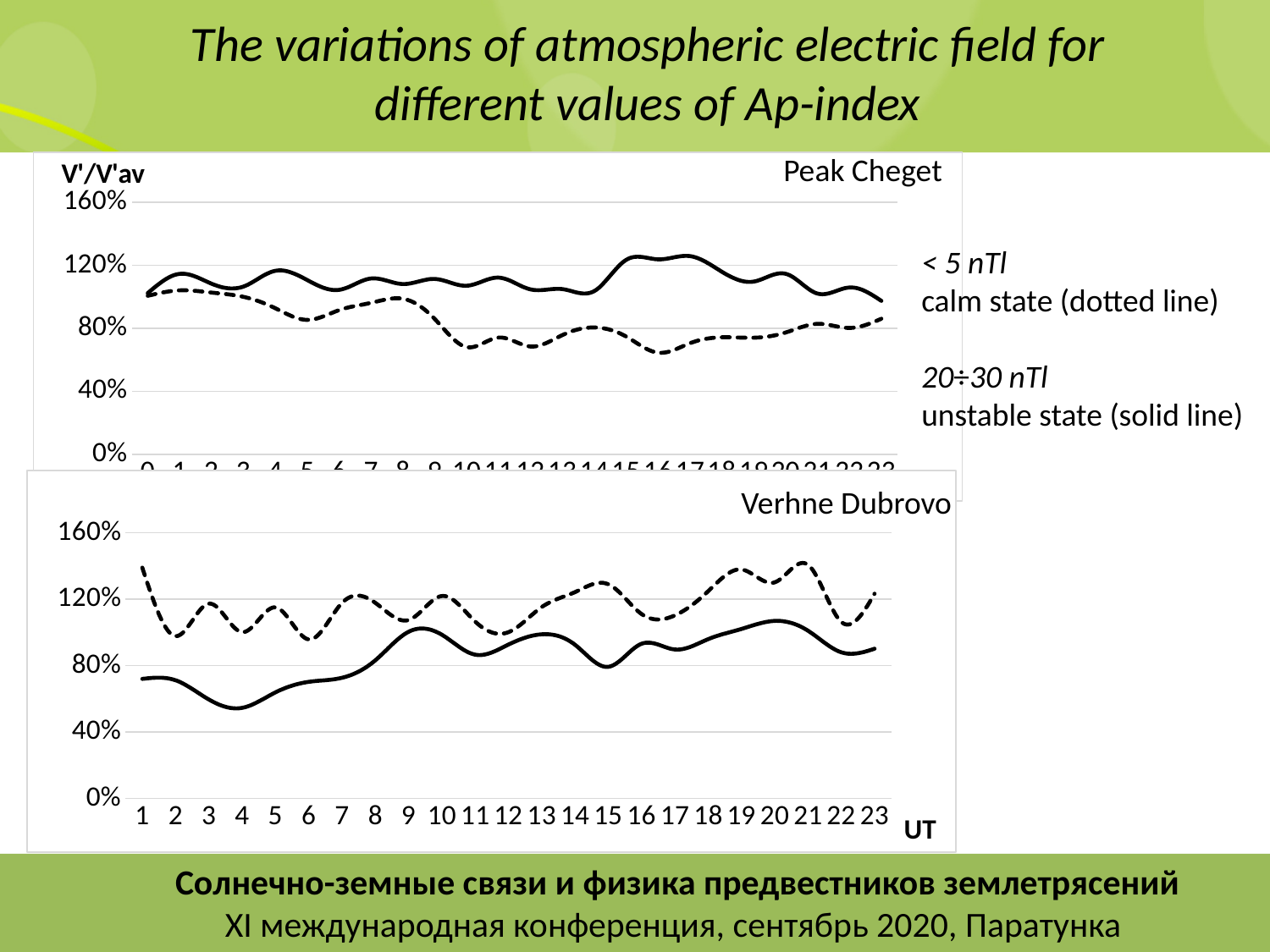
What is the y-axis label shown on the Peak Cheget chart? V'/V'av According to the slide, which line style represents the calm state (< 5 nTl)? dotted line In the Verhne Dubrovo chart, how many hourly points are plotted along the x axis? 23 In the Peak Cheget chart, at hour 16, which line has the higher value: the dotted (calm state) line or the solid (unstable state) line? solid (unstable state) line In the Verhne Dubrovo chart, does the solid (unstable state) line rise or fall between hour 4 and hour 9? rise In the Verhne Dubrovo chart, is the value of the solid (unstable state) line at hour 4 greater or less than 80%? less In the Verhne Dubrovo chart, is the value of the dotted (calm state) line at hour 21 greater or less than 120%? greater In the Verhne Dubrovo chart, is the value of the solid (unstable state) line at hour 9 greater or less than 80%? greater In the Verhne Dubrovo chart, at hour 1, which line has the higher value: the dotted (calm state) line or the solid (unstable state) line? dotted (calm state) line In the Peak Cheget chart, does the dotted (calm state) line rise or fall between hour 0 and hour 10? fall What kind of chart is the Peak Cheget chart? line chart